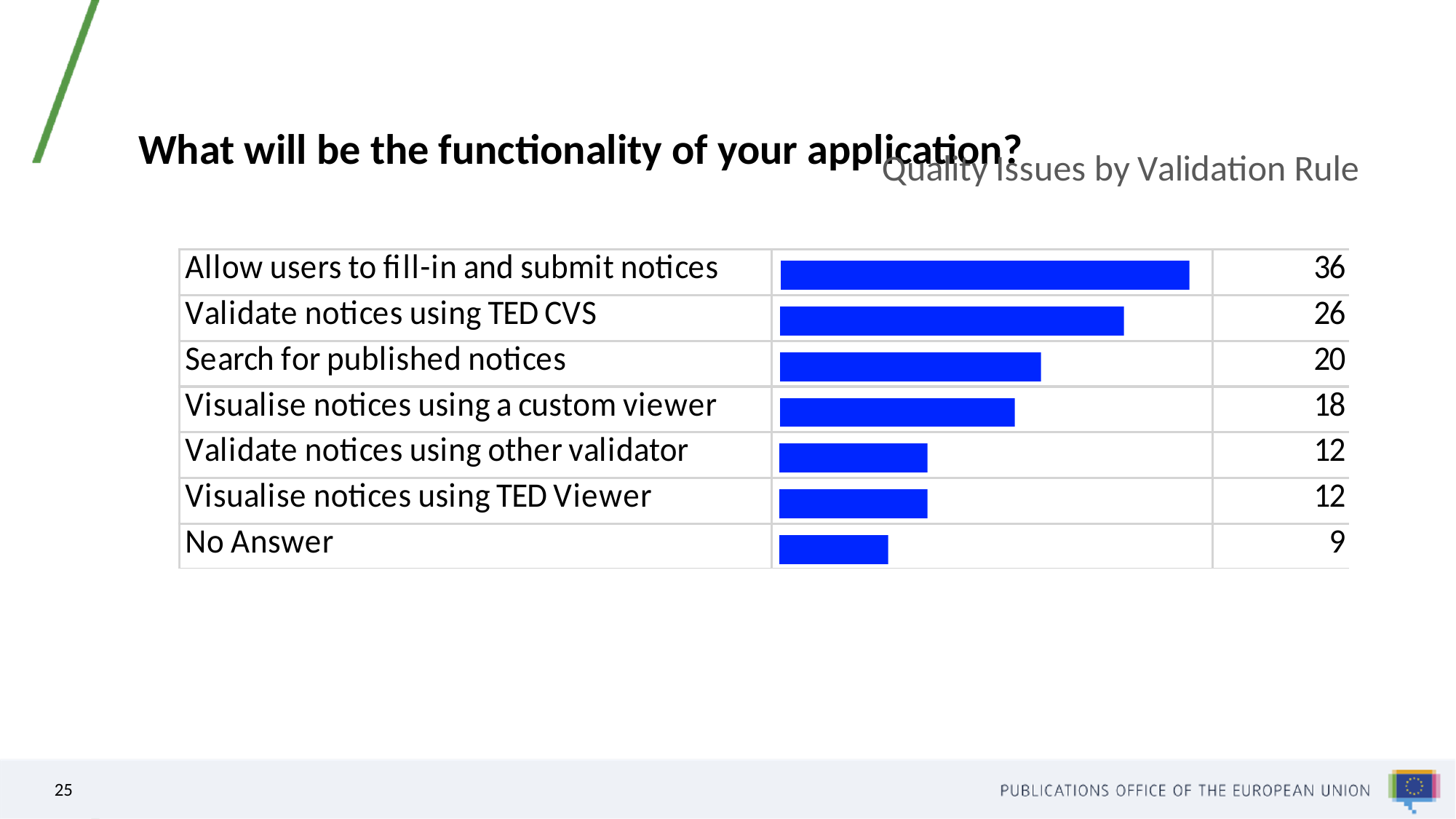
What is the value for "No Answer"? 9 What colour are the bars in the chart? Blue How many categories are shown in the chart? 7 What is the value for "Visualise notices using a custom viewer"? 18 Which is larger: the value for "Search for published notices" or the value for "Visualise notices using a custom viewer"? Search for published notices Which category has the lowest value? No Answer What is the value for "Search for published notices"? 20 What is the difference between the values for "Allow users to fill-in and submit notices" and "Validate notices using TED CVS"? 10 What is the value for "Allow users to fill-in and submit notices"? 36 What kind of chart is shown on the slide? Bar chart What is the value for "Validate notices using TED CVS"? 26 Which category has the highest value? Allow users to fill-in and submit notices